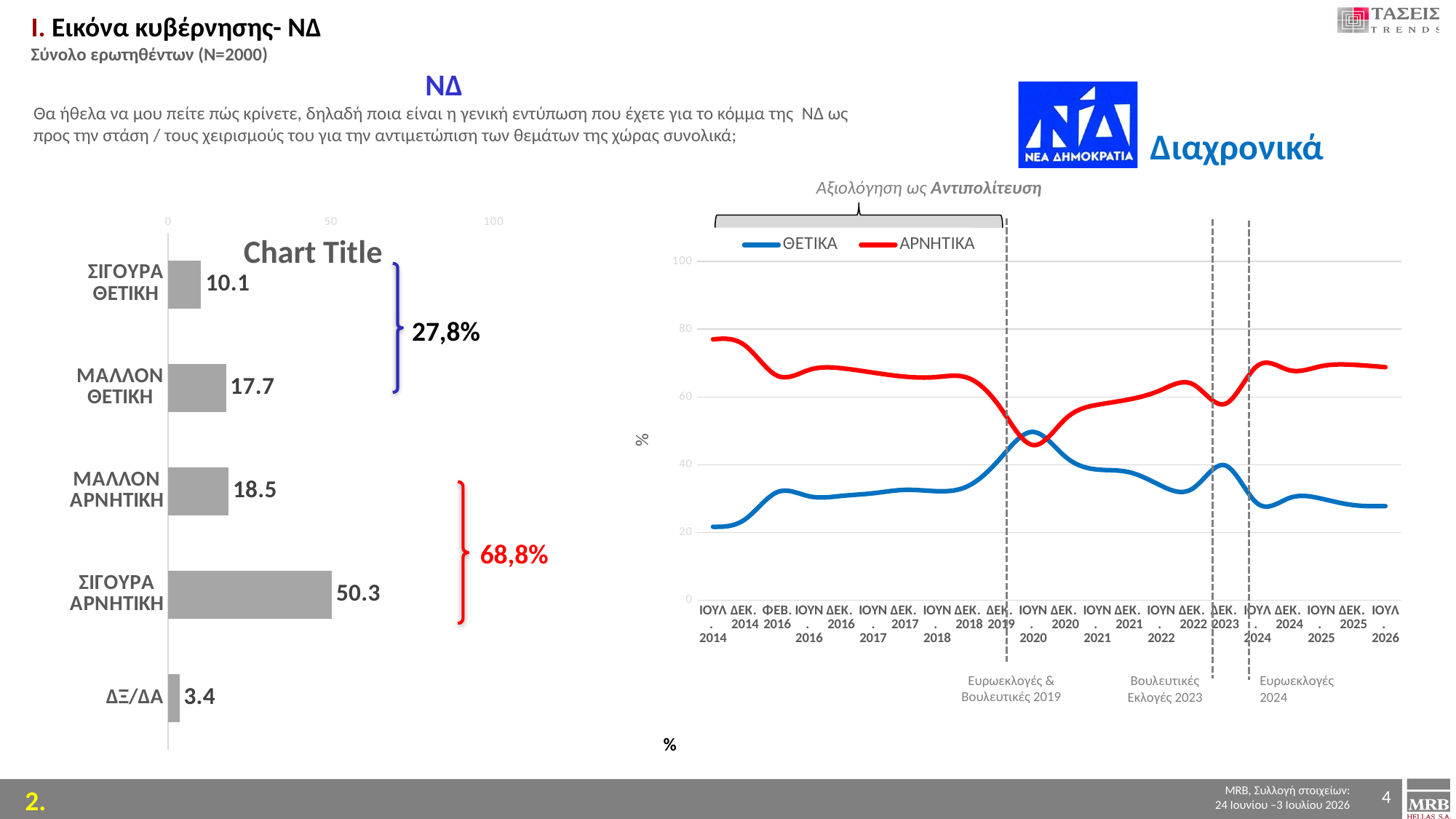
In the bar chart on the left, which category has the highest value? ΣΙΓΟΥΡΑ ΑΡΝΗΤΙΚΗ In the bar chart on the left, what is the difference between ΣΙΓΟΥΡΑ ΑΡΝΗΤΙΚΗ and ΣΙΓΟΥΡΑ ΘΕΤΙΚΗ? 40.2 In the bar chart on the left, what is the value for ΜΑΛΛΟΝ ΘΕΤΙΚΗ? 17.7 In the bar chart on the left, which category has the lowest value? ΔΞ/ΔΑ In the line chart on the right, which colour is used for the ΘΕΤΙΚΑ series? blue In the line chart on the right, is the value of ΑΡΝΗΤΙΚΑ at ΙΟΥΛ. 2014 greater or less than 60? greater How many series does the legend of the line chart on the right list? 2 In the bar chart on the left, which is larger: ΜΑΛΛΟΝ ΘΕΤΙΚΗ or ΣΙΓΟΥΡΑ ΘΕΤΙΚΗ? ΜΑΛΛΟΝ ΘΕΤΙΚΗ How many categories does the bar chart on the left show? 5 In the bar chart on the left, what is the value for ΣΙΓΟΥΡΑ ΑΡΝΗΤΙΚΗ? 50.3 What kind of chart is the chart on the left? bar chart In the bar chart on the left, what is the value for ΔΞ/ΔΑ? 3.4